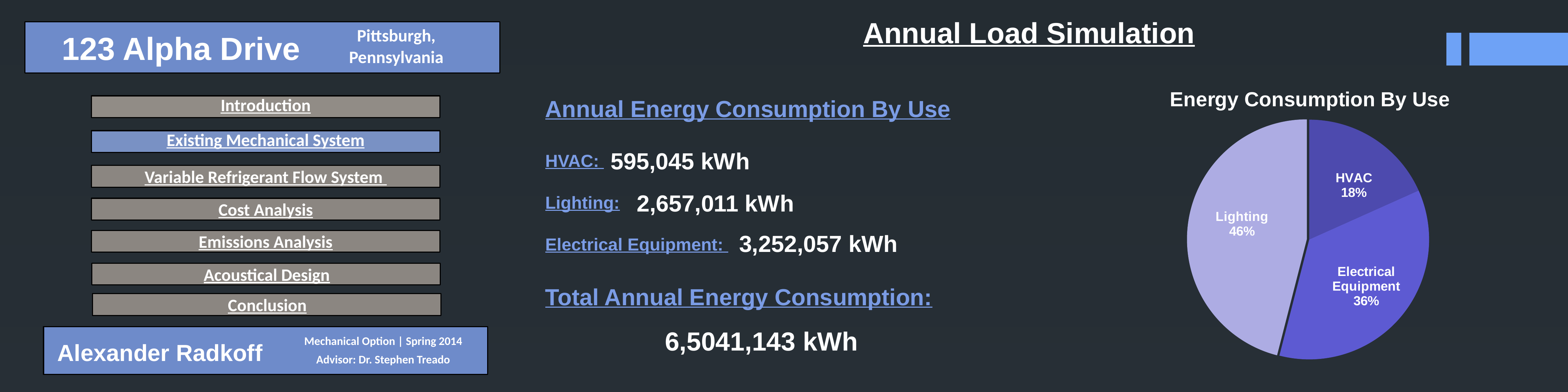
Which slice is larger, Electrical Equipment or HVAC? Electrical Equipment What share of the pie does HVAC represent? 18% What kind of chart is shown on the slide? pie chart How many slices does the pie chart have? 3 Which category has the smallest slice of the pie? HVAC What is the difference in percentage points between the Lighting and HVAC slices? 28 Which category has the largest slice of the pie? Lighting What share of the pie does Lighting represent? 46% What is the difference in percentage points between the Lighting and Electrical Equipment slices? 10 What is the difference in percentage points between the Electrical Equipment and HVAC slices? 18 What is the title of the chart? Energy Consumption By Use What share of the pie does Electrical Equipment represent? 36%